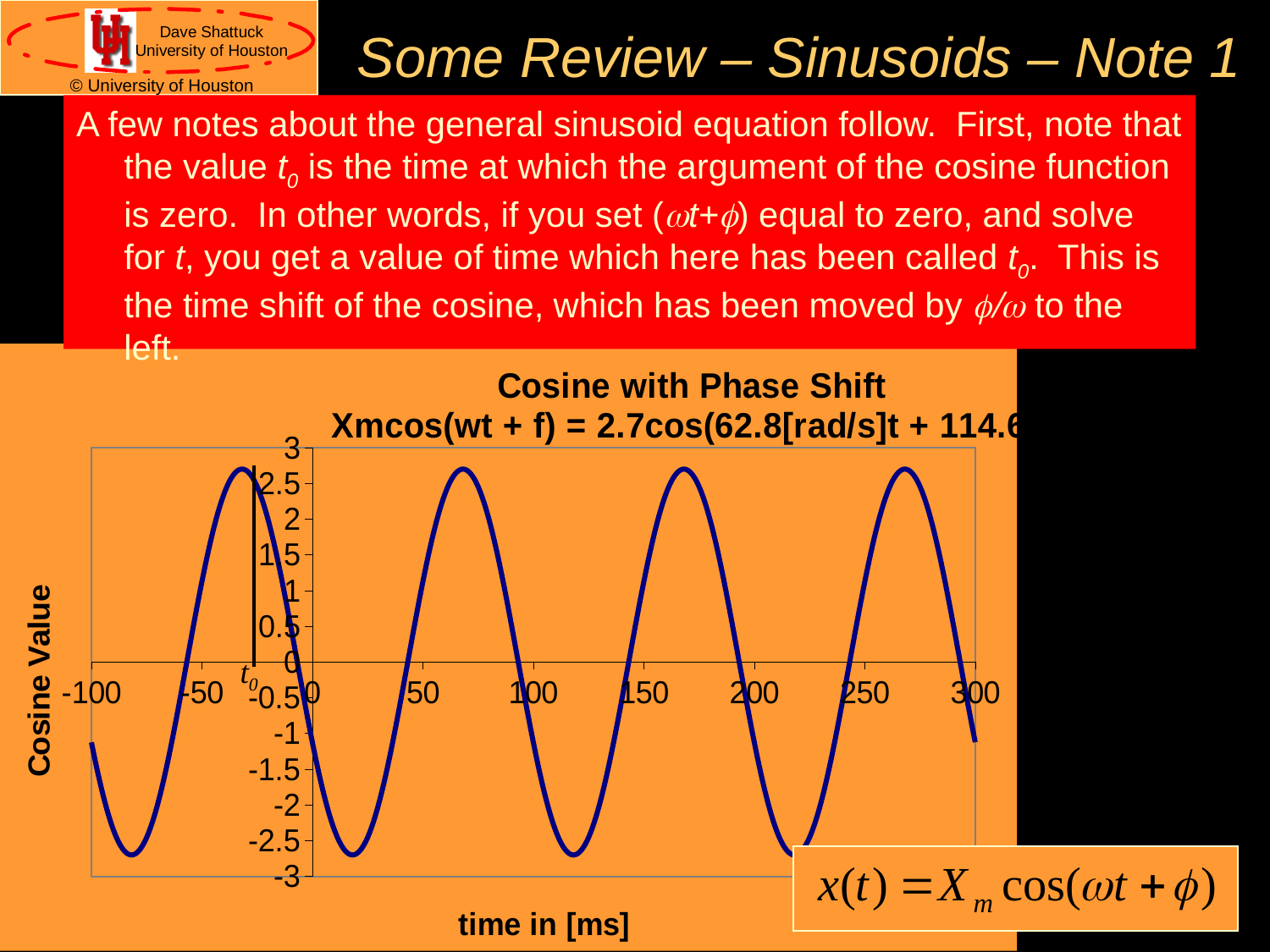
What is the title of the chart (first line)? Cosine with Phase Shift Is the value of the curve at time 250 ms greater or less than 0? greater What is the label of the vertical axis of the chart? Cosine Value Is the peak value of the cosine curve greater or less than 3? less Is the value of the curve at time -50 ms greater or less than 0? greater What kind of chart is shown on the slide? line chart What is the largest tick value shown on the time axis of the chart? 300 How many peaks (maxima) of the cosine curve are plotted within the chart's time range? 4